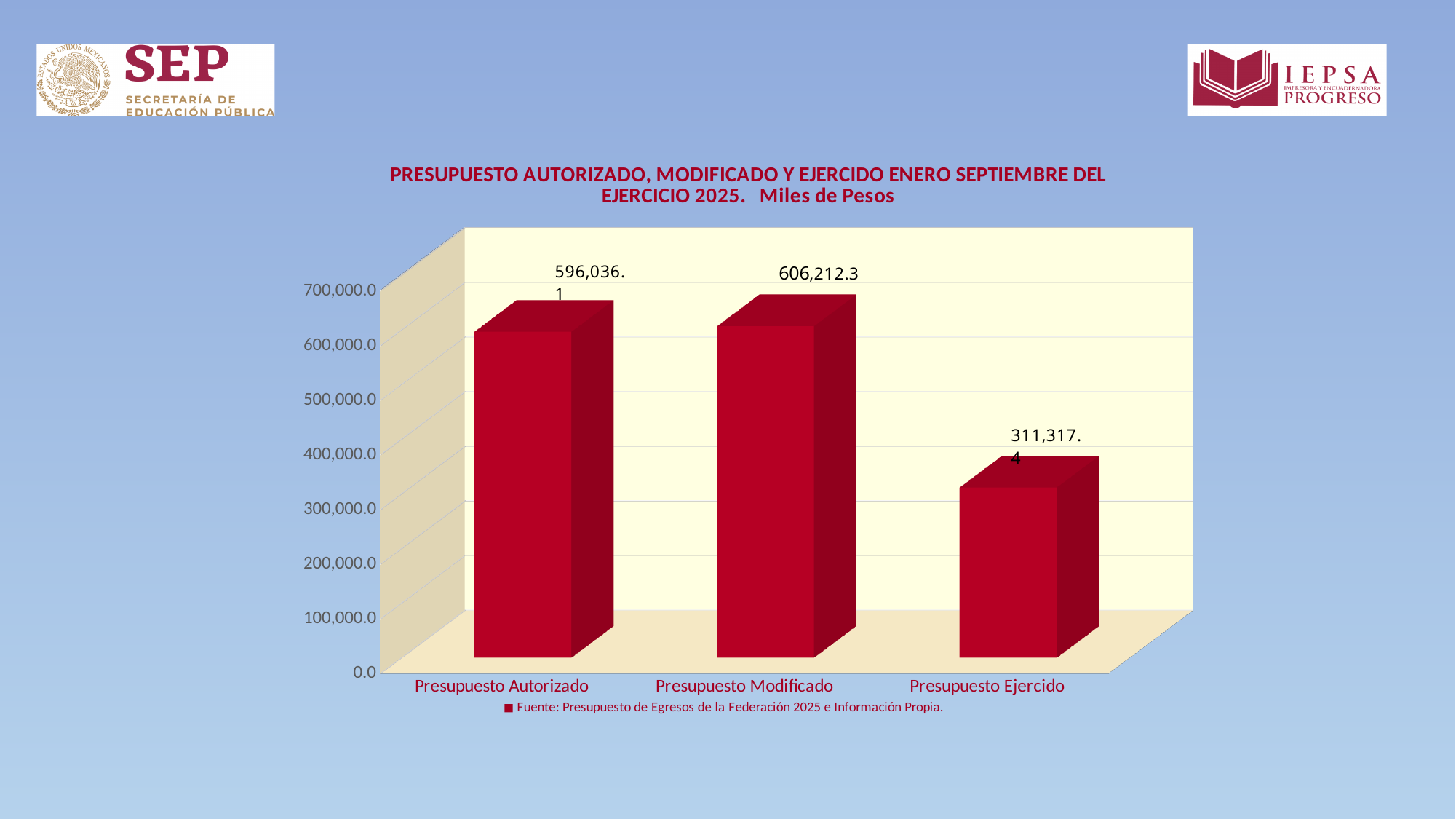
Is the value for Presupuesto Ejercido greater or less than 400,000.0? less What is the value for Presupuesto Modificado? 606,212.3 How many categories are shown on the x axis? 3 What unit does the chart title say the values are in? Miles de Pesos Which category has the lowest value? Presupuesto Ejercido Which category has the highest value? Presupuesto Modificado What kind of chart is shown on the slide? bar chart What is the difference between Presupuesto Autorizado and Presupuesto Ejercido? 284,718.7 What is the value for Presupuesto Autorizado? 596,036.1 What is the value for Presupuesto Ejercido? 311,317.4 Which is larger, Presupuesto Autorizado or Presupuesto Ejercido? Presupuesto Autorizado What is the difference between Presupuesto Modificado and Presupuesto Autorizado? 10,176.2